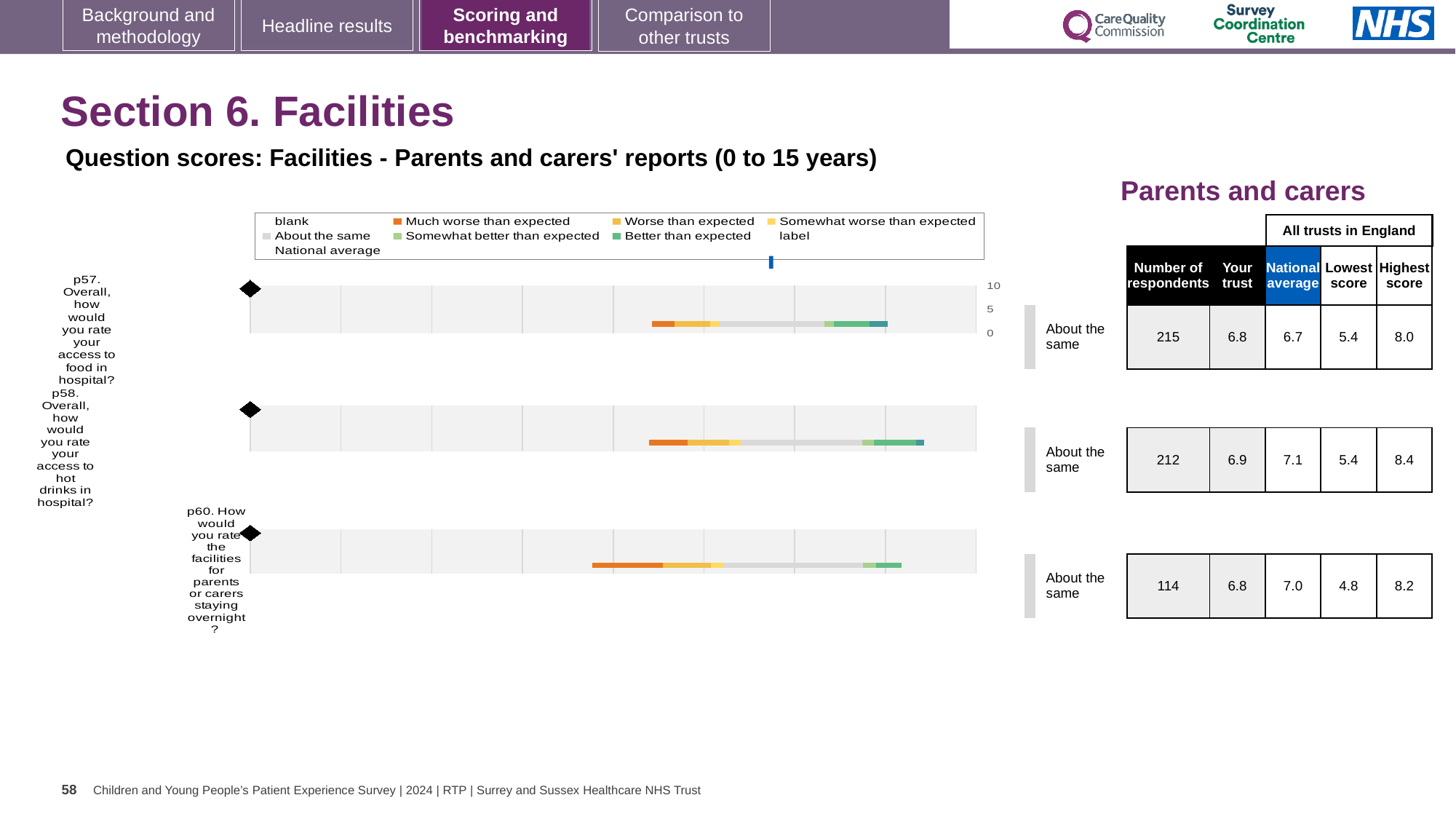
What is the national average score for p58 (access to hot drinks in hospital)? 7.1 How many respondents answered p60 (facilities for parents or carers staying overnight)? 114 Which question has the lowest 'Lowest score' across all trusts in England? p60 How many questions (p57, p58, p60) are plotted on the slide? 3 Which question has the highest 'Highest score' across all trusts in England? p58 What is the 'Your trust' score for p57 (access to food in hospital)? 6.8 What benchmark category is shown for all three questions? About the same How many respondents answered p57? 215 For p57, which is larger: the 'Your trust' score or the national average? Your trust What is the maximum value shown on the score axis of the charts? 10 What type of chart is used to show the question scores on this slide? bar chart For p58, what is the difference between the highest score (8.4) and the lowest score (5.4)? 3.0